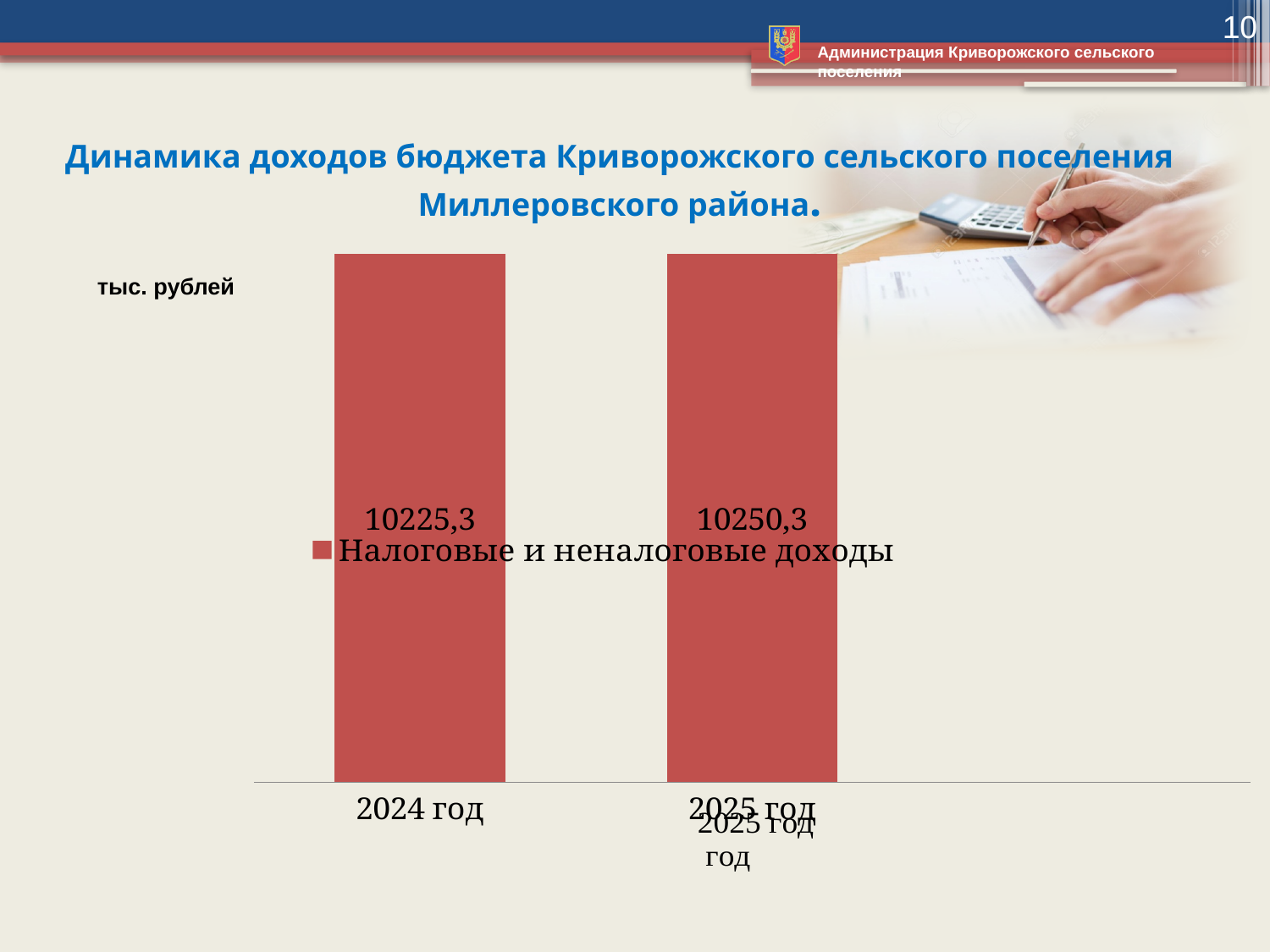
Do the values rise or fall from 2024 год to 2025 год? rise Which year has the lower value according to the data labels? 2024 год Which year has the higher value according to the data labels? 2025 год What is the value for 2024 год? 10225,3 What is the difference between the values for 2025 год and 2024 год? 25 How many series does the legend list? 1 What kind of chart is shown on the slide? bar chart How many categories (years) are shown on the chart? 2 In what units are the chart values given? тыс. рублей What is the value for 2025 год? 10250,3 What series name is listed in the chart legend? Налоговые и неналоговые доходы Is the value for 2025 год larger or smaller than the value for 2024 год? larger